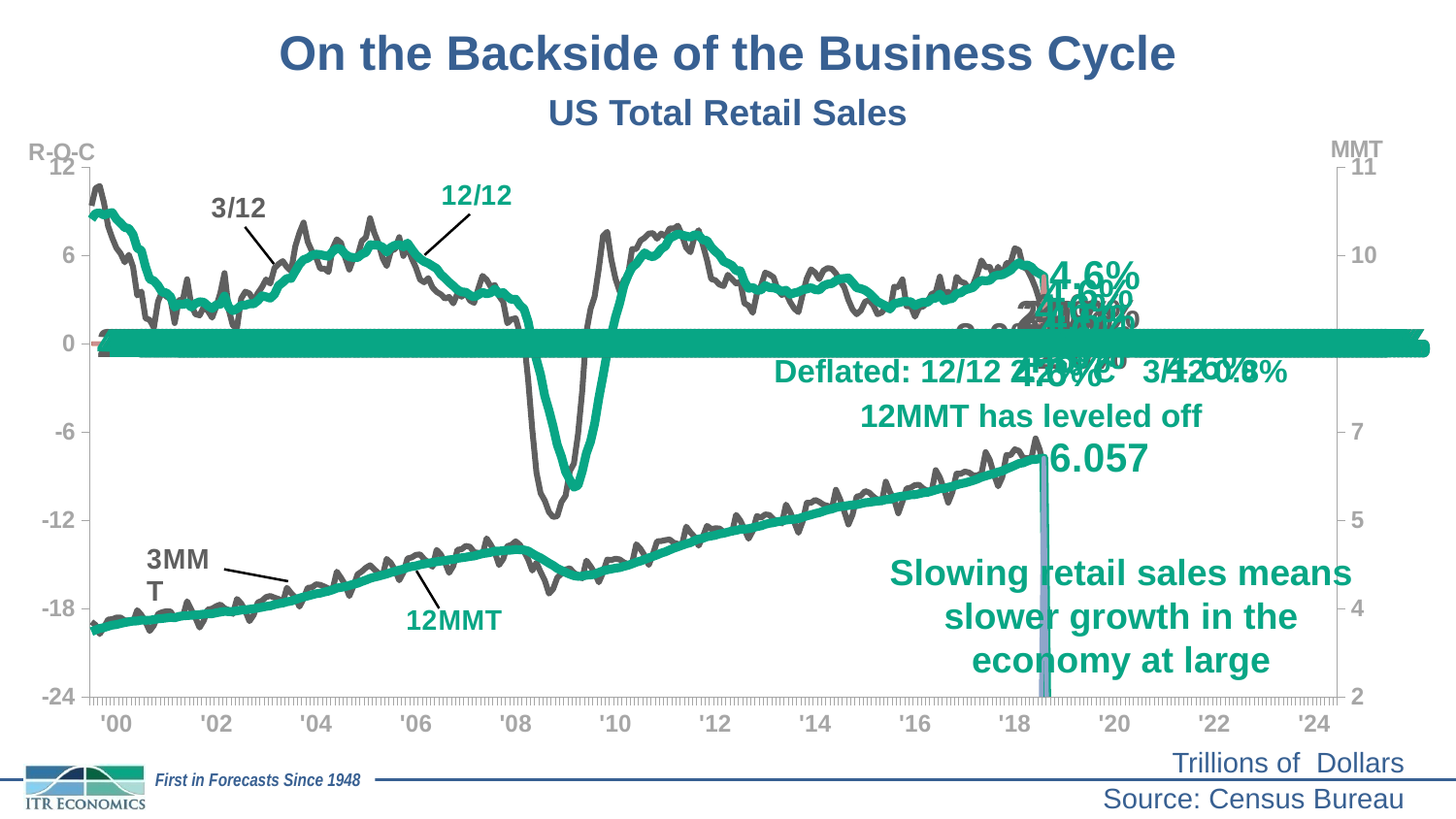
How many data series are plotted on the chart? 4 Around which year does the 12/12 line reach its lowest point? '09 What units are given for the right-hand MMT axis? Trillions of Dollars Is the lowest value of the 12/12 line greater or less than -6 on the R-O-C axis? less Which series is labeled with the value 6.057? 12MMT Is the 12/12 value higher around '00 or around '11? '00 Is the 12MMT value in '10 greater or less than 5 on the MMT axis? less What is the latest value printed for the 12MMT line? 6.057 What kind of chart is shown on the slide? line chart Does the 12MMT line rise or fall from '00 to '18? rise What is the source of the data shown on the chart? Census Bureau